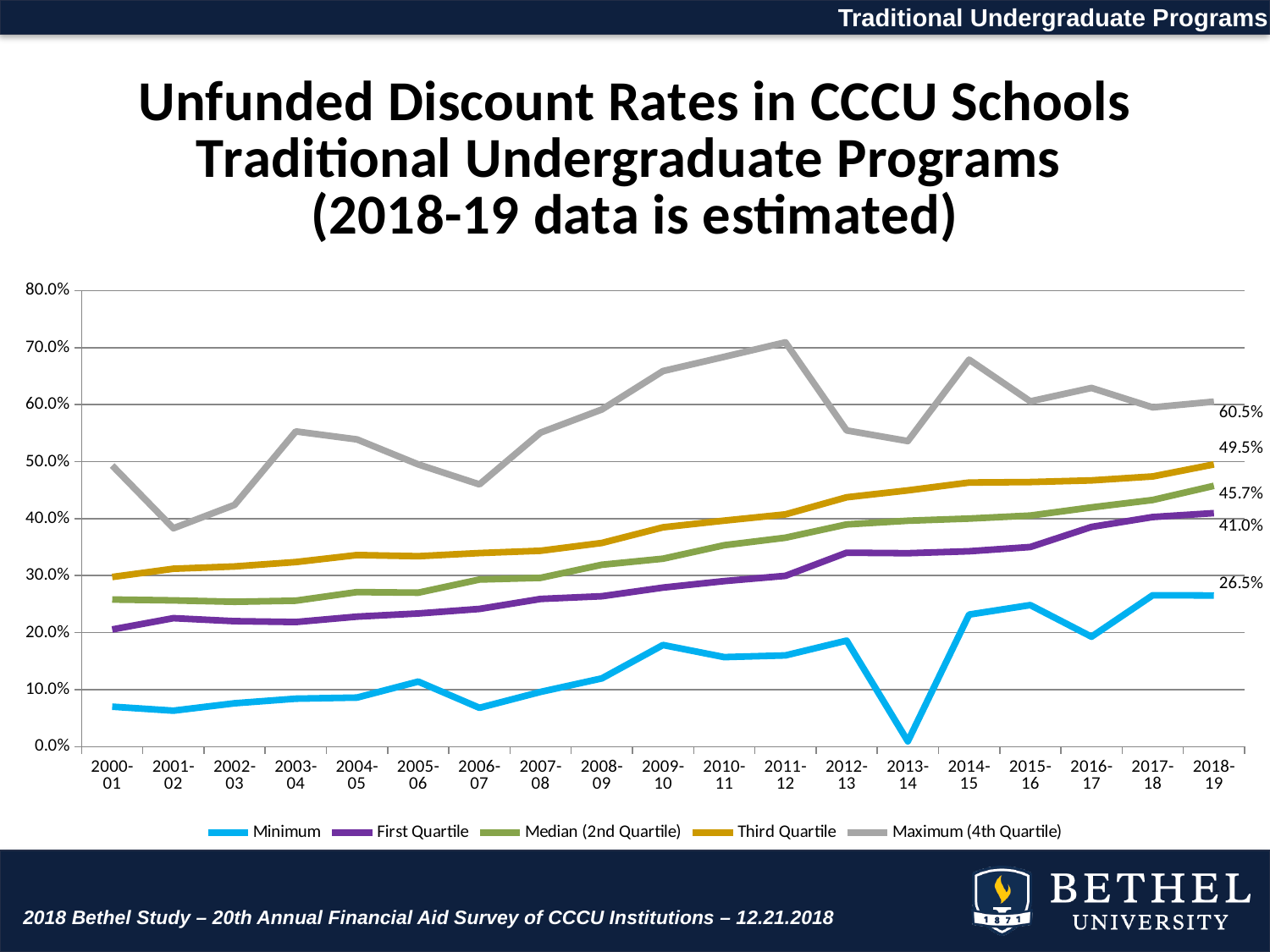
In which year does the Minimum series reach its lowest value? 2013-14 How many academic years are plotted along the x axis? 19 What is the First Quartile value for 2018-19? 41.0% What is the Third Quartile value for 2018-19? 49.5% What is the difference between the Maximum (4th Quartile) and Minimum values in 2018-19? 34.0% How many series does the legend list? 5 Is the Median (2nd Quartile) value for 2000-01 greater or less than 30.0%? less What is the Median (2nd Quartile) value for 2018-19? 45.7% What kind of chart is shown on the slide? line chart In which year does the Maximum (4th Quartile) series reach its highest value? 2011-12 What is the Minimum value for 2018-19? 26.5% What is the Maximum (4th Quartile) value for 2018-19? 60.5%